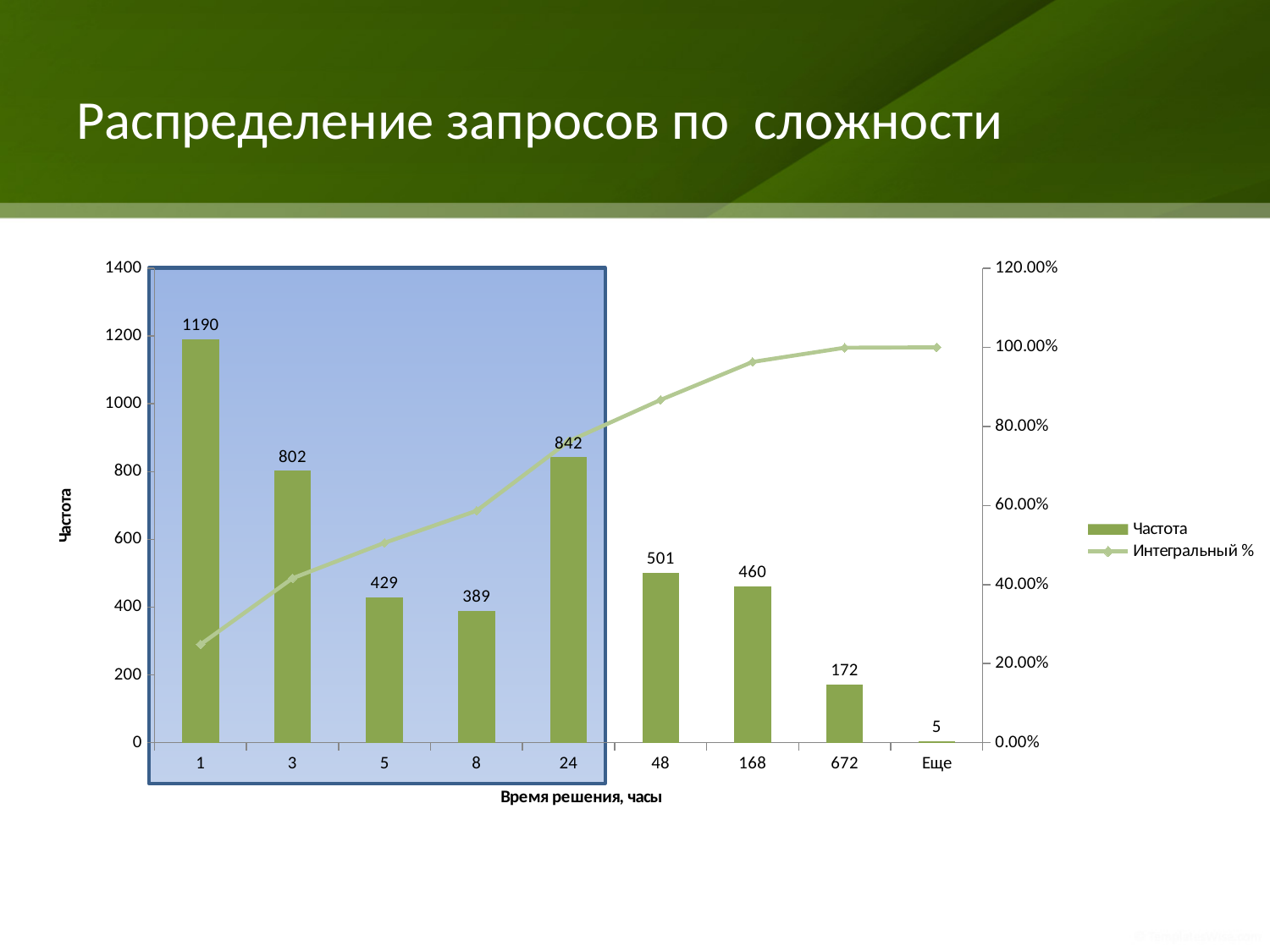
What is the Частота value for the category 672? 172 What is the Частота value for the category 24? 842 Which category has the lowest Частота value? Еще Is the Интегральный % value for category 48 greater or less than 80.00%? greater How many series does the legend list? 2 What is the label of the x axis? Время решения, часы Which category has the highest Частота value? 1 How many categories are shown on the x axis? 9 What is the Частота value for the category 1 on the x axis? 1190 Which has a larger Частота value, category 48 or category 168? 48 What is the difference between the Частота values for categories 1 and 3? 388 Is the Интегральный % value for category 1 greater or less than 40.00%? less